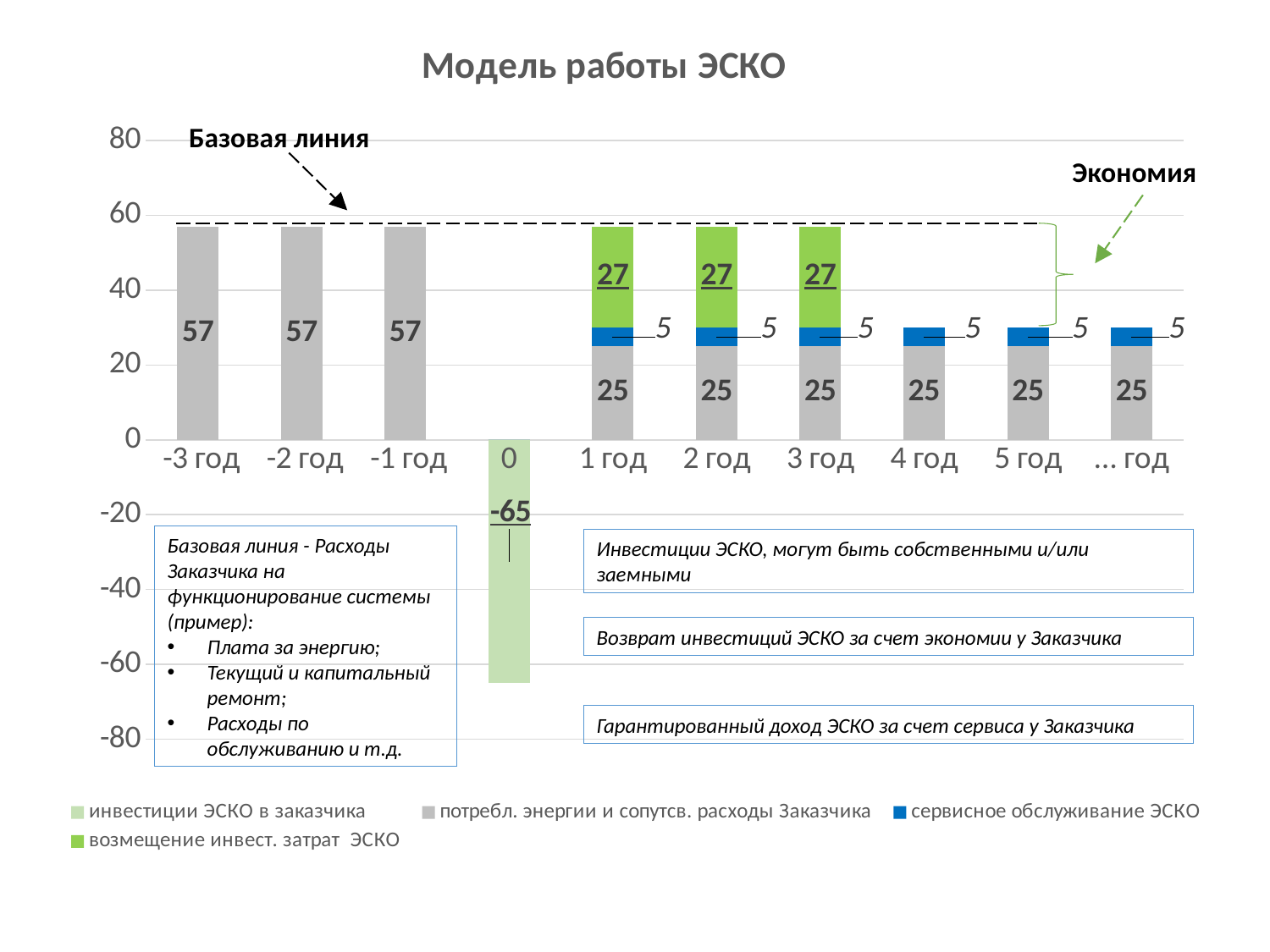
What is the total of the stacked bar for 1 год? 57 What is the value of the blue segment (сервисное обслуживание ЭСКО) for 4 год? 5 Which category has the lowest bar value? 0 What is the value of the green segment (возмещение инвест. затрат ЭСКО) for 2 год? 27 What is the value of the bar for category 0 (инвестиции ЭСКО в заказчика)? -65 What is the difference between the grey segment for -1 год and the grey segment for 1 год? 32 What is the value of the grey bar (потребл. энергии и сопутсв. расходы Заказчика) for -3 год? 57 What type of chart is shown on the slide? bar chart How many series does the legend list? 4 What is the title of the chart? Модель работы ЭСКО How many categories are shown on the x axis? 10 What is the total of the stacked bar for 5 год? 30